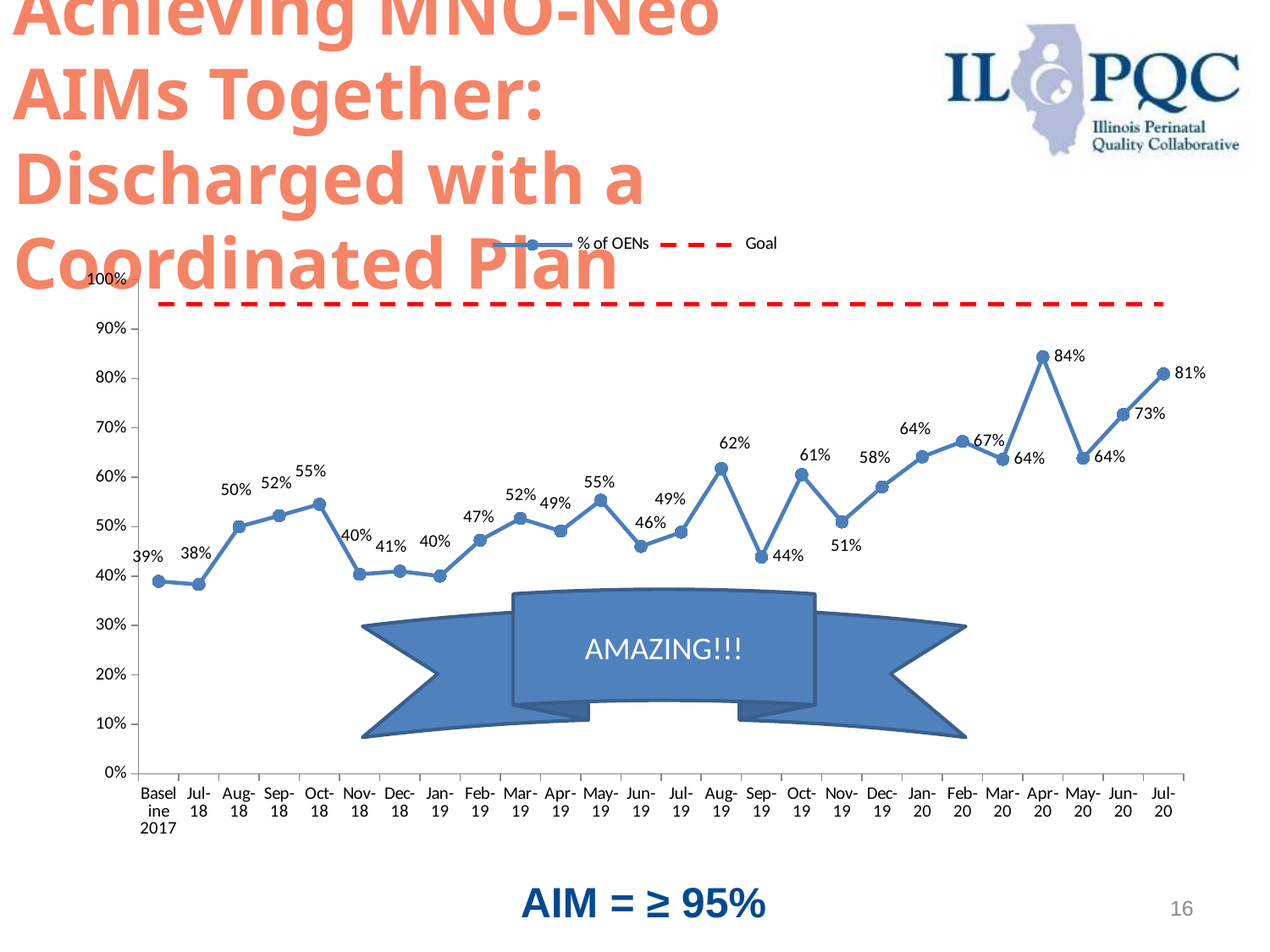
What is the value for Apr-20? 84% What is the value for Jul-20? 81% What is the difference between the values for Jul-20 and Baseline 2017? 42% What is the AIM goal stated below the chart? ≥ 95% Which month has the lowest % of OENs? Jul-18 What is the value for Baseline 2017? 39% How many series does the legend list? 2 How many data points are plotted on the % of OENs line? 26 What is the value for Aug-19? 62% Which month has the highest % of OENs? Apr-20 What kind of chart is shown on the slide? Line chart Which is larger, the value for Oct-19 or the value for Nov-19? Oct-19